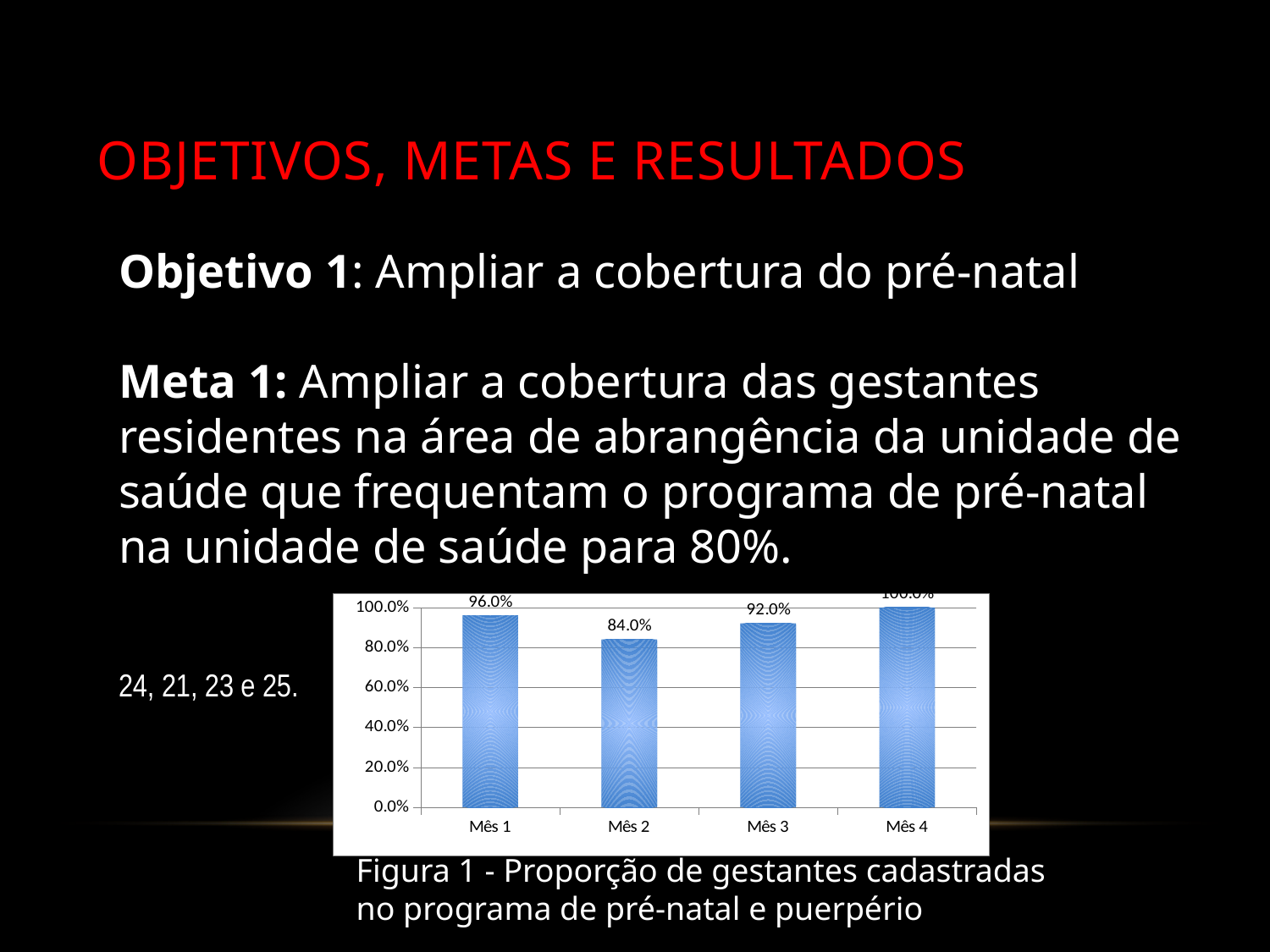
What is the difference between the values for Mês 1 and Mês 2? 12.0% What is the caption of the figure below the chart? Figura 1 - Proporção de gestantes cadastradas no programa de pré-natal e puerpério What kind of chart is shown on the slide? bar chart Which month has the lowest value? Mês 2 What is the value for Mês 2? 84.0% What is the value for Mês 1? 96.0% What is the value for Mês 3? 92.0% How many months are shown on the x axis? 4 Is the value for Mês 2 greater or less than 80.0%? greater Which month has the highest value? Mês 4 What is the difference between the values for Mês 3 and Mês 2? 8.0% Which is larger, the value for Mês 1 or the value for Mês 3? Mês 1